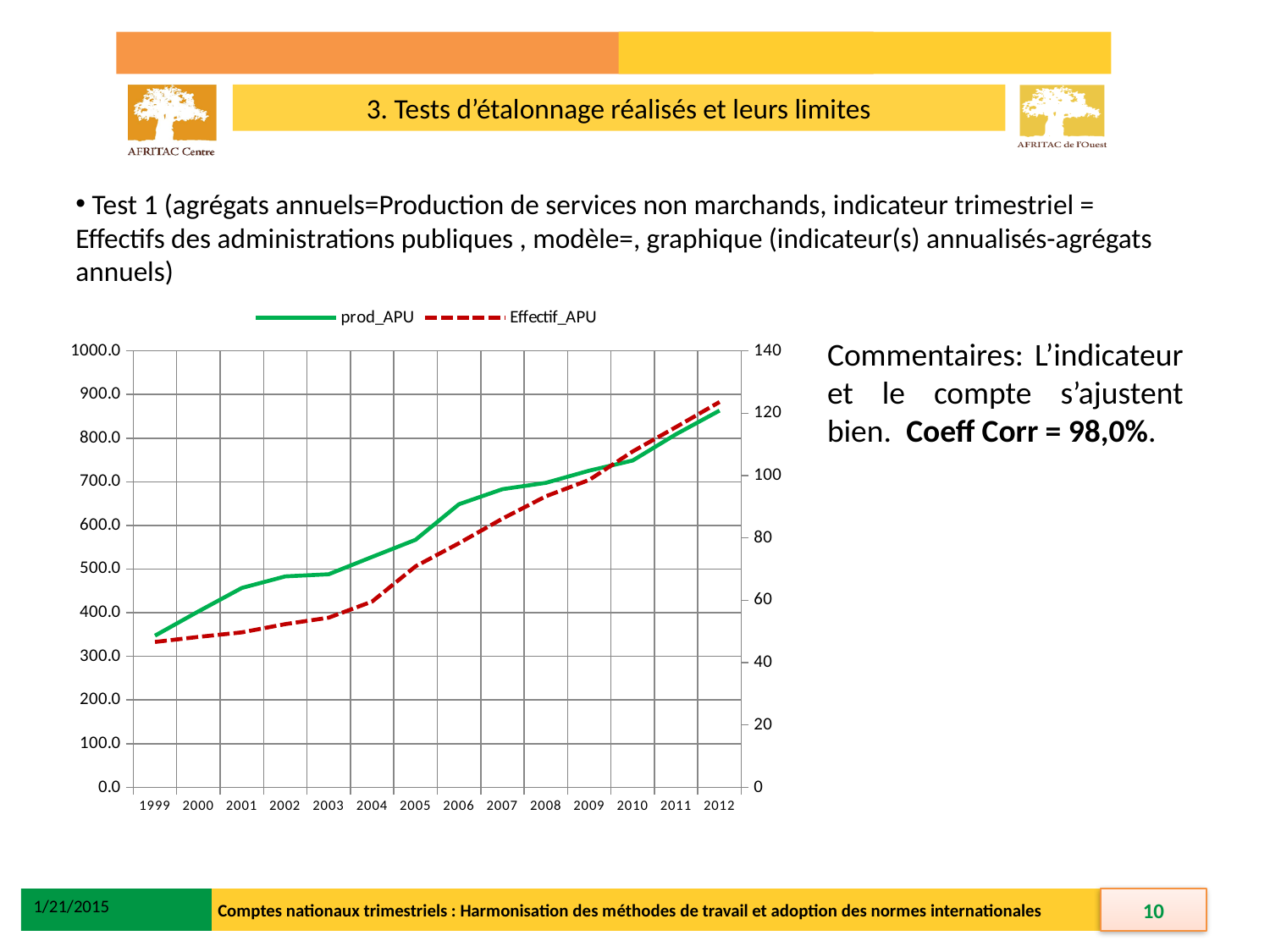
What is the first year shown on the x axis of the chart? 1999 Is the prod_APU value for 2012 greater or less than 800.0 on the left axis? greater How many years are shown on the x axis of the chart? 14 What is the last year shown on the x axis of the chart? 2012 Does the Effectif_APU line rise or fall from 1999 to 2012? rise Is the prod_APU value for 1999 greater or less than 400.0 on the left axis? less How many series does the chart legend list? 2 What kind of chart is shown on the slide? line chart Which series is drawn as a red dashed line in the chart? Effectif_APU Does the prod_APU line rise or fall from 1999 to 2012? rise What are the names of the two series in the chart legend? prod_APU and Effectif_APU Is the prod_APU value for 2006 greater or less than 600.0 on the left axis? greater